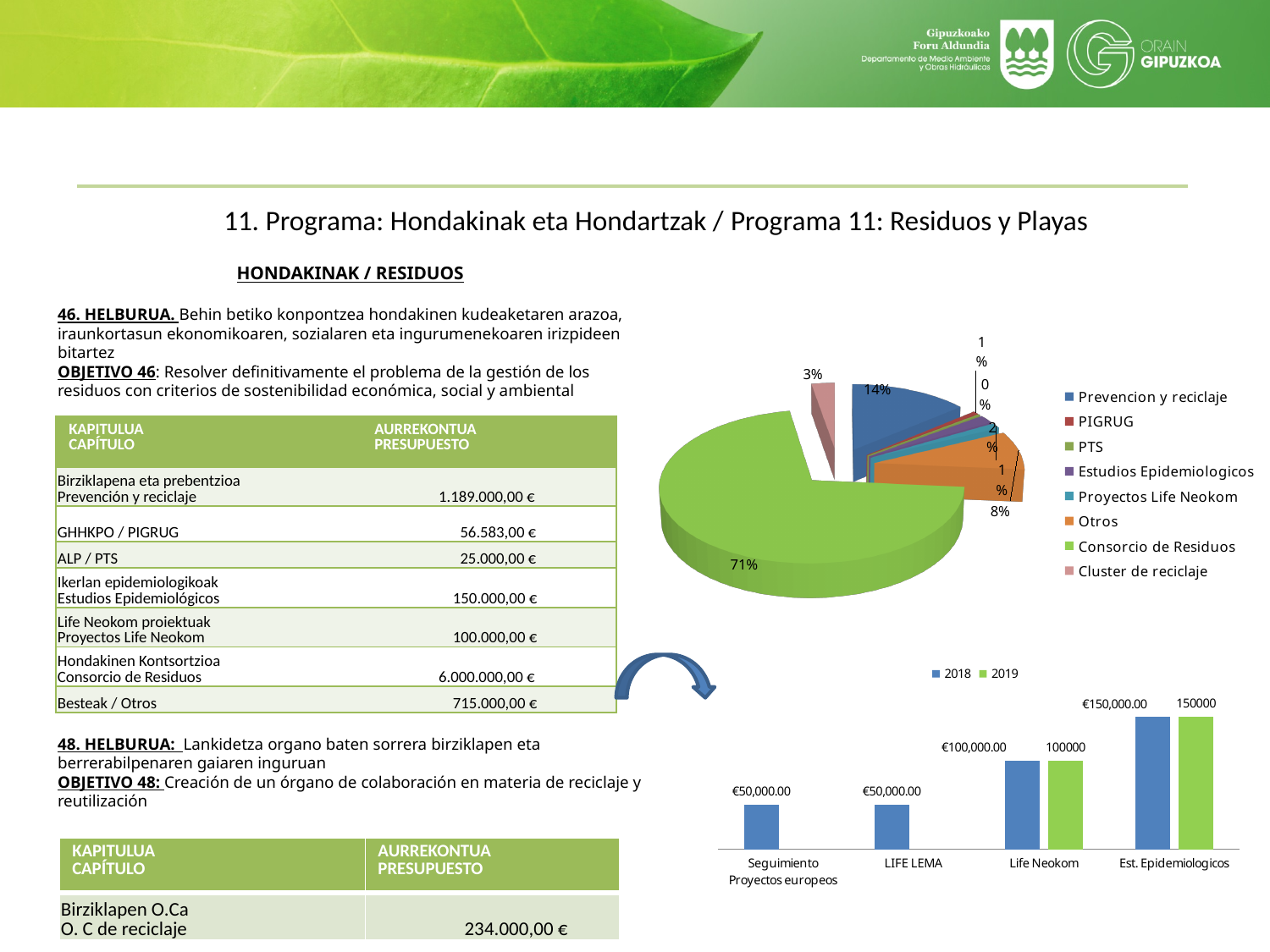
How many series does the legend of the bar chart at the bottom right list? 2 How many categories does the legend of the pie chart list? 8 In the pie chart, which category has the largest slice? Consorcio de Residuos In the pie chart, what share does Consorcio de Residuos have? 71% In the bar chart at the bottom right, what is the 2019 value for Life Neokom? 100000 In the bar chart at the bottom right, what is the 2018 value for LIFE LEMA? €50,000.00 In the pie chart, what share does Otros have? 8% In the bar chart at the bottom right, which category has the highest 2018 value? Est. Epidemiologicos In the pie chart, what share does Prevencion y reciclaje have? 14% In the bar chart at the bottom right, what is the 2018 value for Est. Epidemiologicos? €150,000.00 What kind of chart is the chart at the top right of the slide? Pie chart In the bar chart at the bottom right, how many categories are shown on the x axis? 4